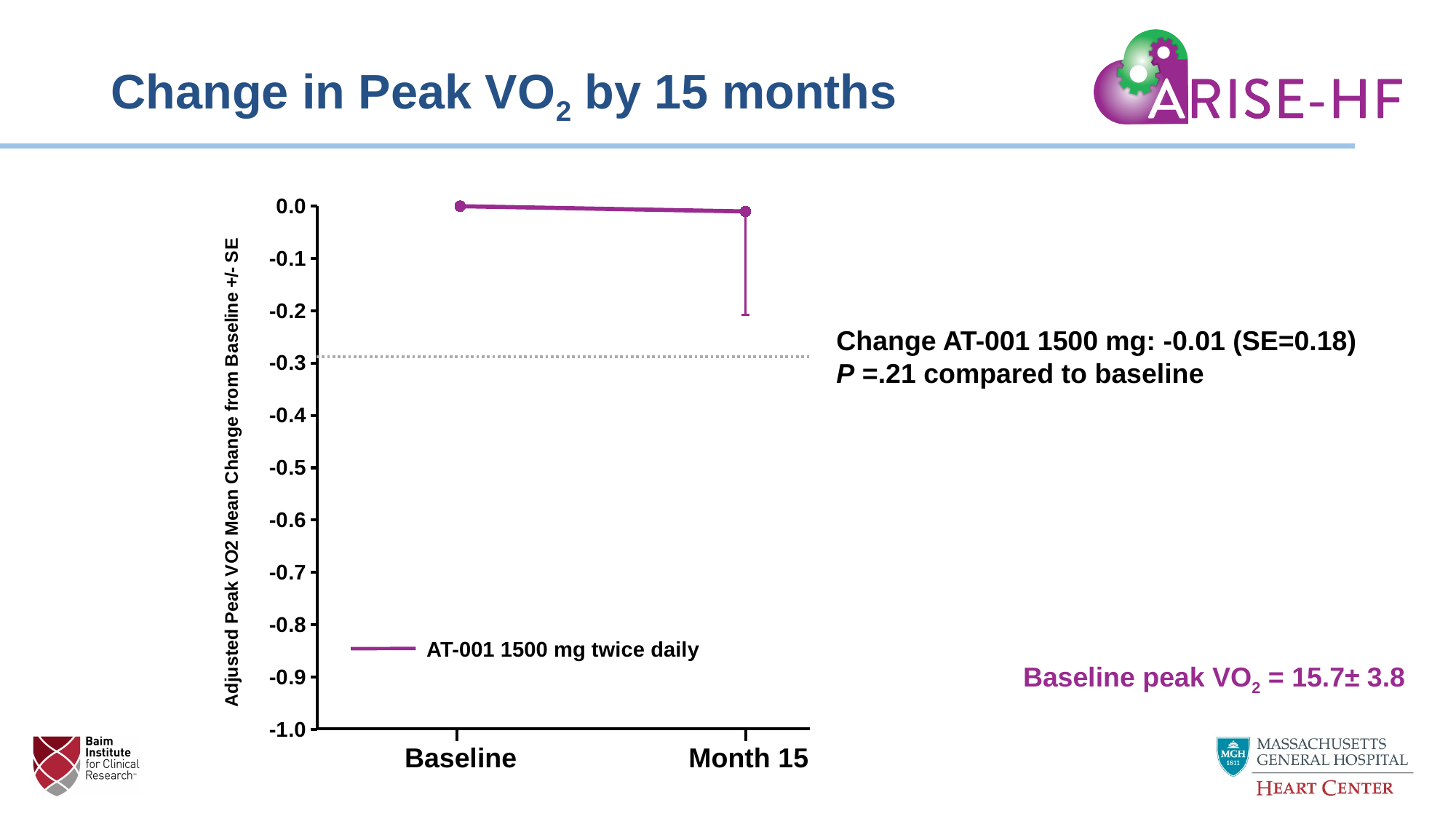
What is the standard error (SE) of the change at Month 15 for AT-001 1500 mg? 0.18 What is the plotted value at Baseline? 0.0 What is the lowest value shown on the y axis? -1.0 What is the name of the series shown in the legend? AT-001 1500 mg twice daily What is the label of the y axis? Adjusted Peak VO2 Mean Change from Baseline +/- SE How many time points are plotted on the x axis? 2 Is the value at Month 15 greater or less than -0.1? greater What is the adjusted peak VO2 mean change from baseline at Month 15 for AT-001 1500 mg? -0.01 Is the value at Month 15 greater or less than -0.5? greater How many series does the legend list? 1 What kind of chart is shown on the slide? line chart Does the plotted line rise or fall from Baseline to Month 15? fall